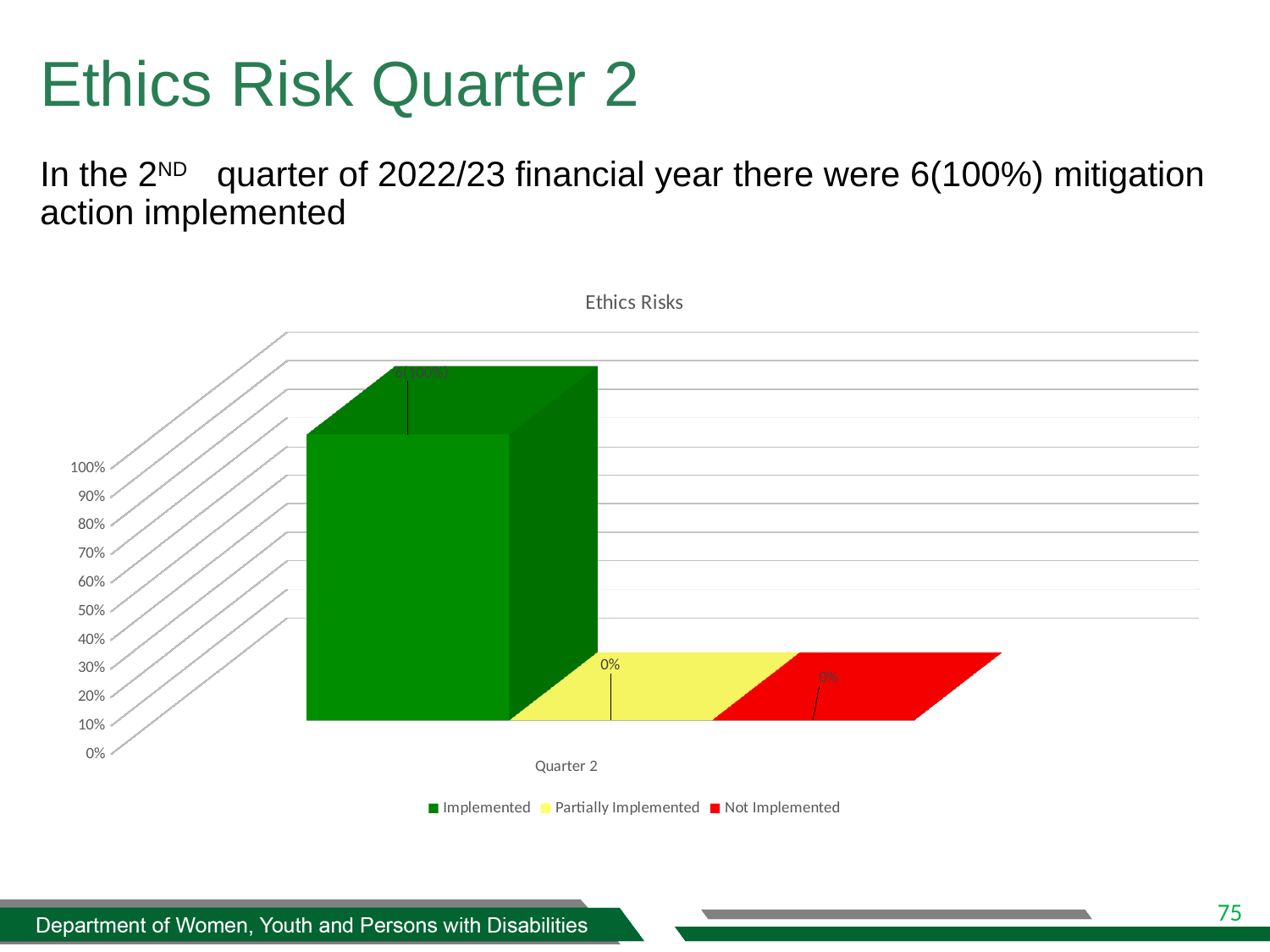
How many series does the chart legend list? 3 What is the value for Not Implemented in Quarter 2? 0% Which series has the highest value in Quarter 2? Implemented What is the title of the chart? Ethics Risks Is the value for Implemented in Quarter 2 greater or less than 50%? greater Which is larger in Quarter 2, Implemented or Not Implemented? Implemented What is the difference between the Partially Implemented and Not Implemented values in Quarter 2? 0% What is the value for Partially Implemented in Quarter 2? 0% What is the category label shown on the x axis? Quarter 2 How many categories are shown on the x axis of the chart? 1 Which colour represents the Not Implemented series in the chart? red What kind of chart is shown on the slide? bar chart